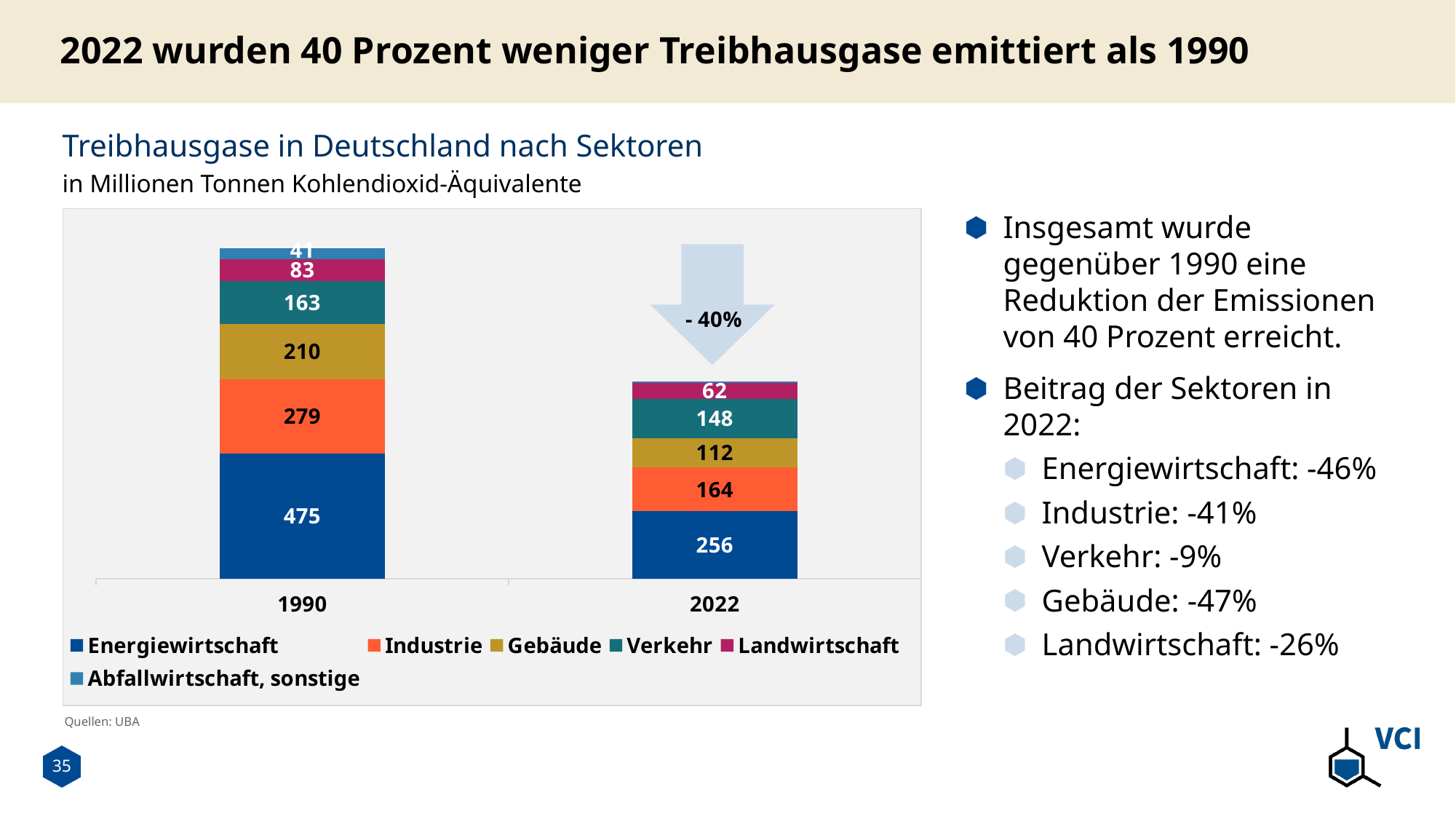
What type of chart is shown on the slide? stacked bar chart Which is larger in 2022: Verkehr or Gebäude? Verkehr What is the total of the stacked bar for 1990? 1251 How many categories (years) are shown on the x axis? 2 How many series does the legend list? 6 What is the value for Gebäude in 2022? 112 What is the value for Energiewirtschaft in 1990? 475 What is the value for Industrie in 2022? 164 By how much did the Energiewirtschaft value fall from 1990 to 2022? 219 What is the value for Verkehr in 1990? 163 What is the value for Landwirtschaft in 2022? 62 What is the title of the chart? Treibhausgase in Deutschland nach Sektoren